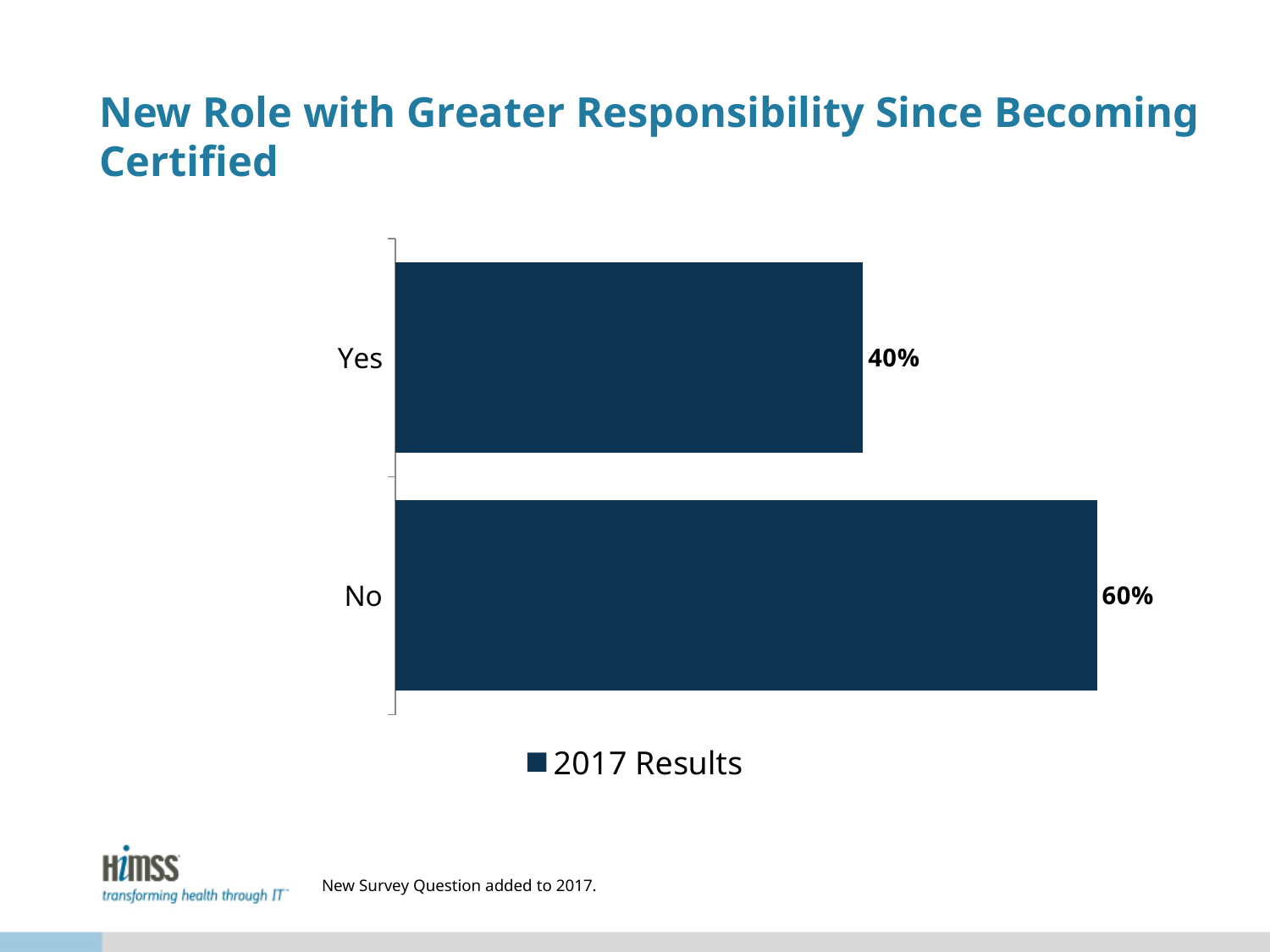
Is the value for Yes larger or smaller than the value for No? smaller How many response categories are shown in the chart? 2 What percentage of respondents answered Yes to having a new role with greater responsibility since becoming certified? 40% Which response category has the lower value? Yes What is the difference in percentage points between the No and Yes responses? 20 percentage points What type of chart is shown on the slide? bar chart What series name is shown in the legend? 2017 Results What is the total of the Yes and No percentages? 100% How many series does the legend list? 1 What is the title of the chart on the slide? New Role with Greater Responsibility Since Becoming Certified What percentage of respondents answered No? 60% Which response category has the higher value? No